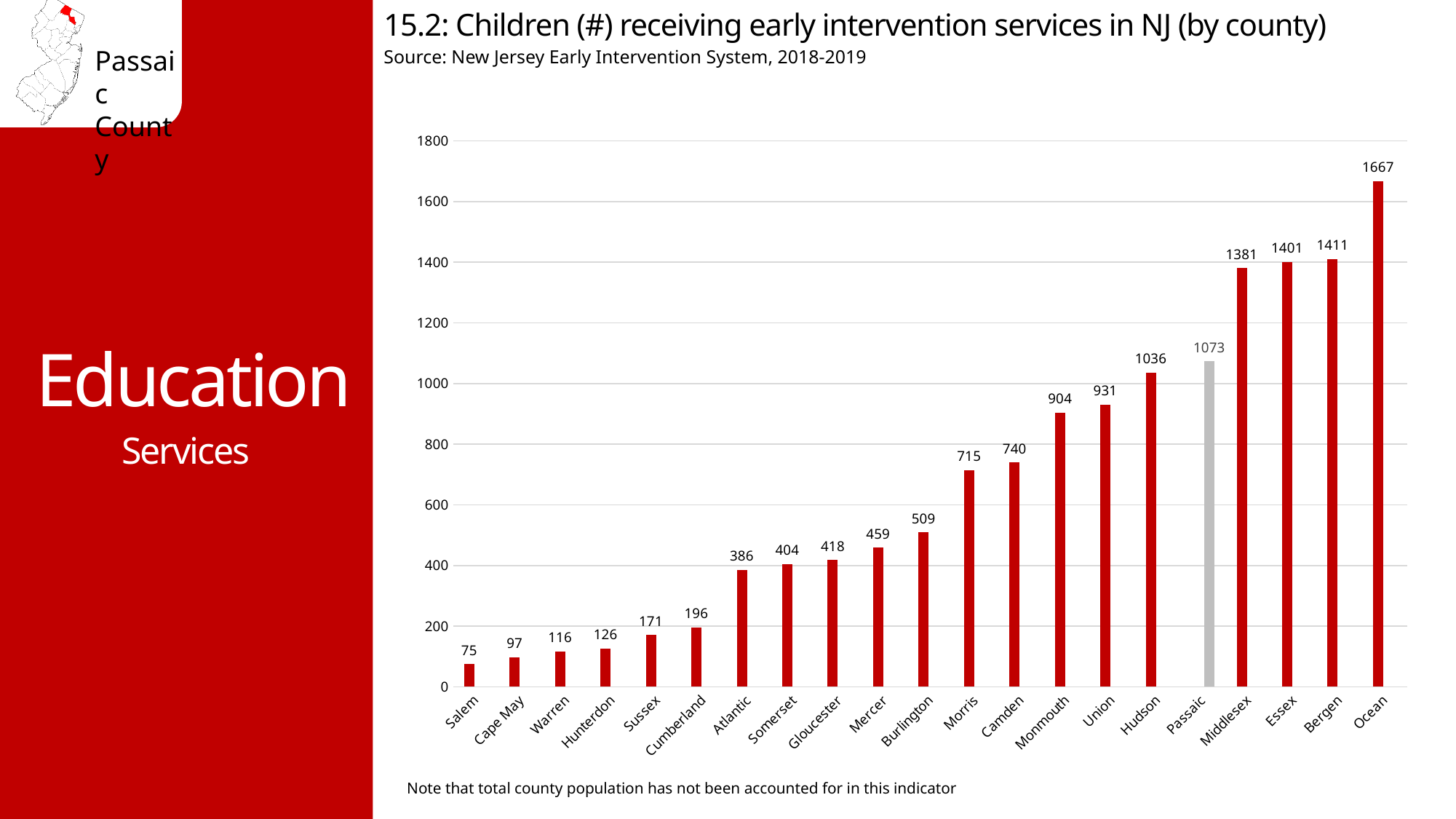
What kind of chart is shown on the slide? bar chart What is the difference between the values for Ocean and Bergen? 256 What is the value shown for Cumberland County? 196 How many counties are shown on the x axis? 21 Which county has a larger value, Morris or Camden? Camden Which county has the lowest number of children receiving early intervention services? Salem Which county has the highest number of children receiving early intervention services? Ocean Which county's bar is coloured grey instead of red? Passaic What is the value shown for Hudson County? 1036 Is the value for Monmouth greater or less than 1000? less How many children received early intervention services in Passaic County? 1073 What is the difference between the values for Passaic and Hudson? 37